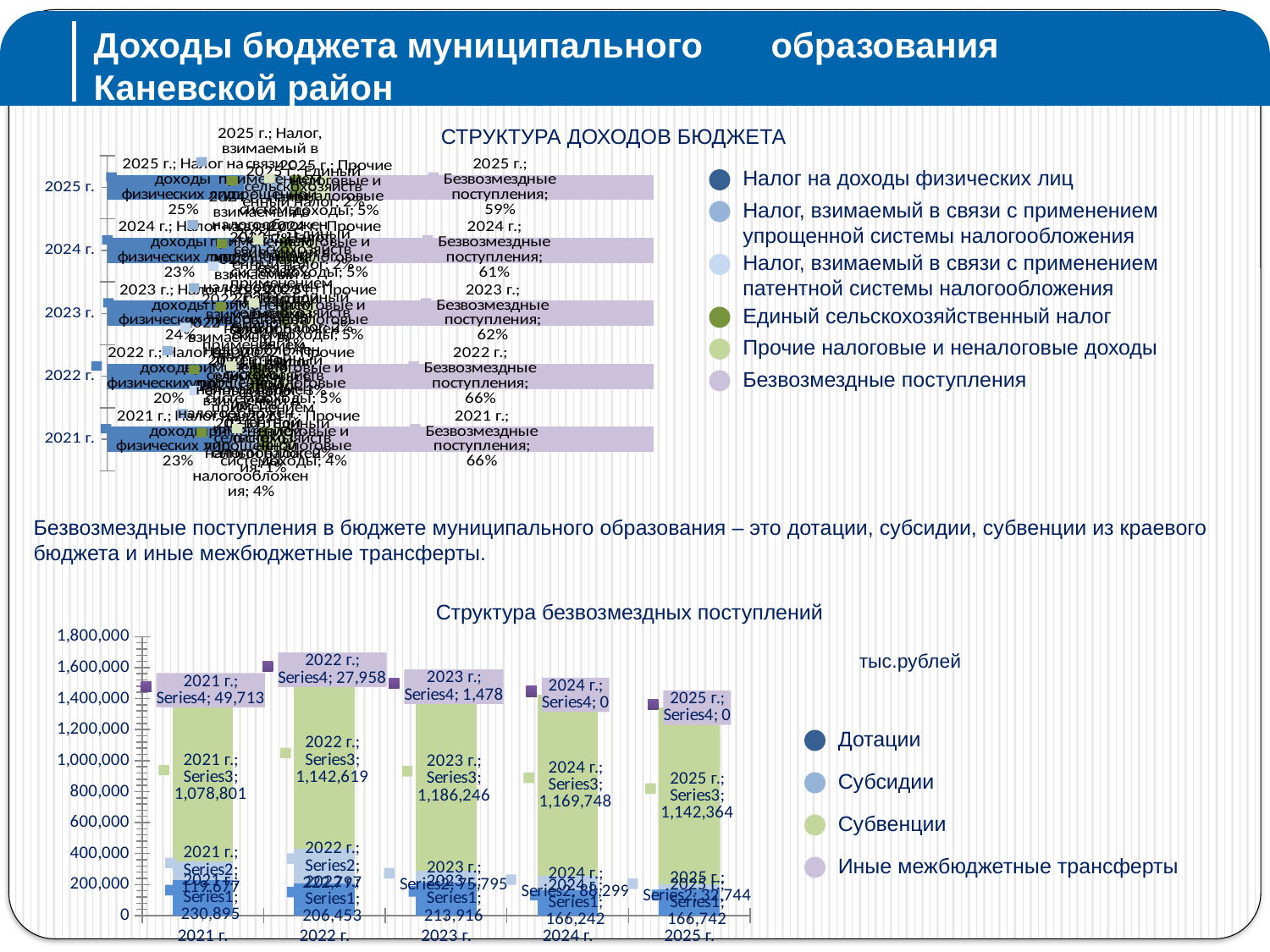
In the chart 'Структура безвозмездных поступлений', how many entries does the legend list? 4 In the chart 'Структура безвозмездных поступлений', what is the Series4 value for 2021 г.? 49,713 In the chart 'СТРУКТУРА ДОХОДОВ БЮДЖЕТА', what is the share of Безвозмездные поступления in 2025 г.? 59% In the chart 'Структура безвозмездных поступлений', what is the Series1 value for 2025 г.? 166,742 In the chart 'Структура безвозмездных поступлений', which year has the highest Series3 value? 2023 г. In the chart 'СТРУКТУРА ДОХОДОВ БЮДЖЕТА', does the share of Безвозмездные поступления rise or fall from 2021 г. to 2025 г.? Fall In the chart 'Структура безвозмездных поступлений', what is the Series3 value for 2023 г.? 1,186,246 In the chart 'Структура безвозмездных поступлений', which is larger: the Series1 value for 2021 г. or for 2022 г.? 2021 г. What kind of chart is 'Структура безвозмездных поступлений'? Stacked bar chart In the chart 'Структура безвозмездных поступлений', how many years are shown on the x axis? 5 In the chart 'СТРУКТУРА ДОХОДОВ БЮДЖЕТА', how many entries does the legend list? 6 In the chart 'Структура безвозмездных поступлений', what is the difference between the Series3 values for 2022 г. and 2021 г.? 63,818